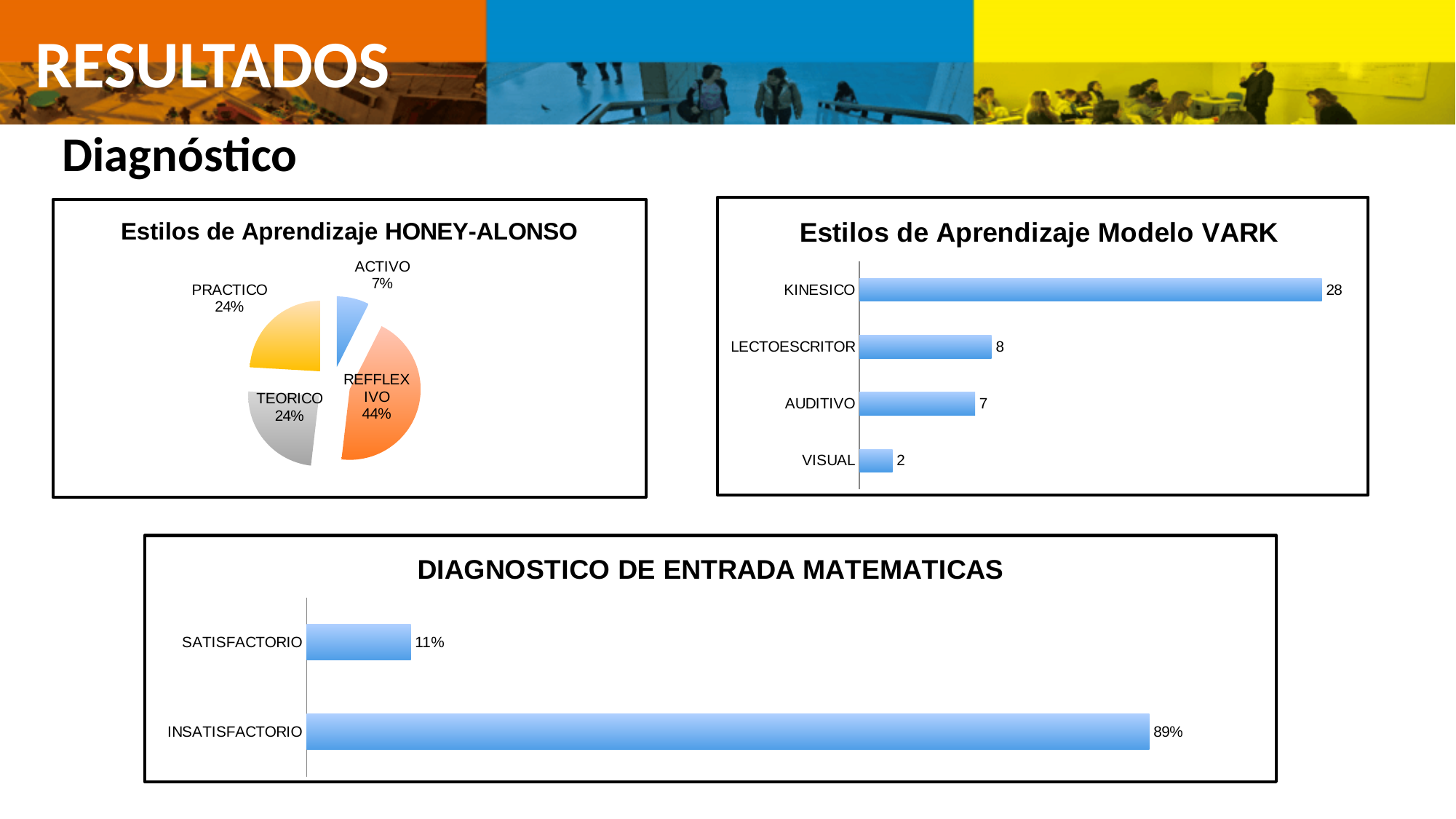
In the 'Estilos de Aprendizaje HONEY-ALONSO' chart, which category has the smallest slice? ACTIVO In the 'Estilos de Aprendizaje Modelo VARK' chart, which is larger, LECTOESCRITOR or AUDITIVO? LECTOESCRITOR In the 'Estilos de Aprendizaje Modelo VARK' chart, which category has the lowest value? VISUAL In the 'DIAGNOSTICO DE ENTRADA MATEMATICAS' chart, what is the difference between INSATISFACTORIO and SATISFACTORIO? 78% In the 'Estilos de Aprendizaje Modelo VARK' chart, what is the value for KINESICO? 28 In the 'DIAGNOSTICO DE ENTRADA MATEMATICAS' chart, how many categories are shown? 2 In the 'Estilos de Aprendizaje HONEY-ALONSO' chart, what kind of chart is shown? Pie chart In the 'Estilos de Aprendizaje HONEY-ALONSO' chart, how many categories are shown? 4 In the 'Estilos de Aprendizaje Modelo VARK' chart, what kind of chart is shown? Bar chart In the 'Estilos de Aprendizaje Modelo VARK' chart, what is the difference between KINESICO and LECTOESCRITOR? 20 In the 'DIAGNOSTICO DE ENTRADA MATEMATICAS' chart, what is the value for INSATISFACTORIO? 89% In the 'Estilos de Aprendizaje HONEY-ALONSO' chart, what share does REFFLEXIVO have? 44%